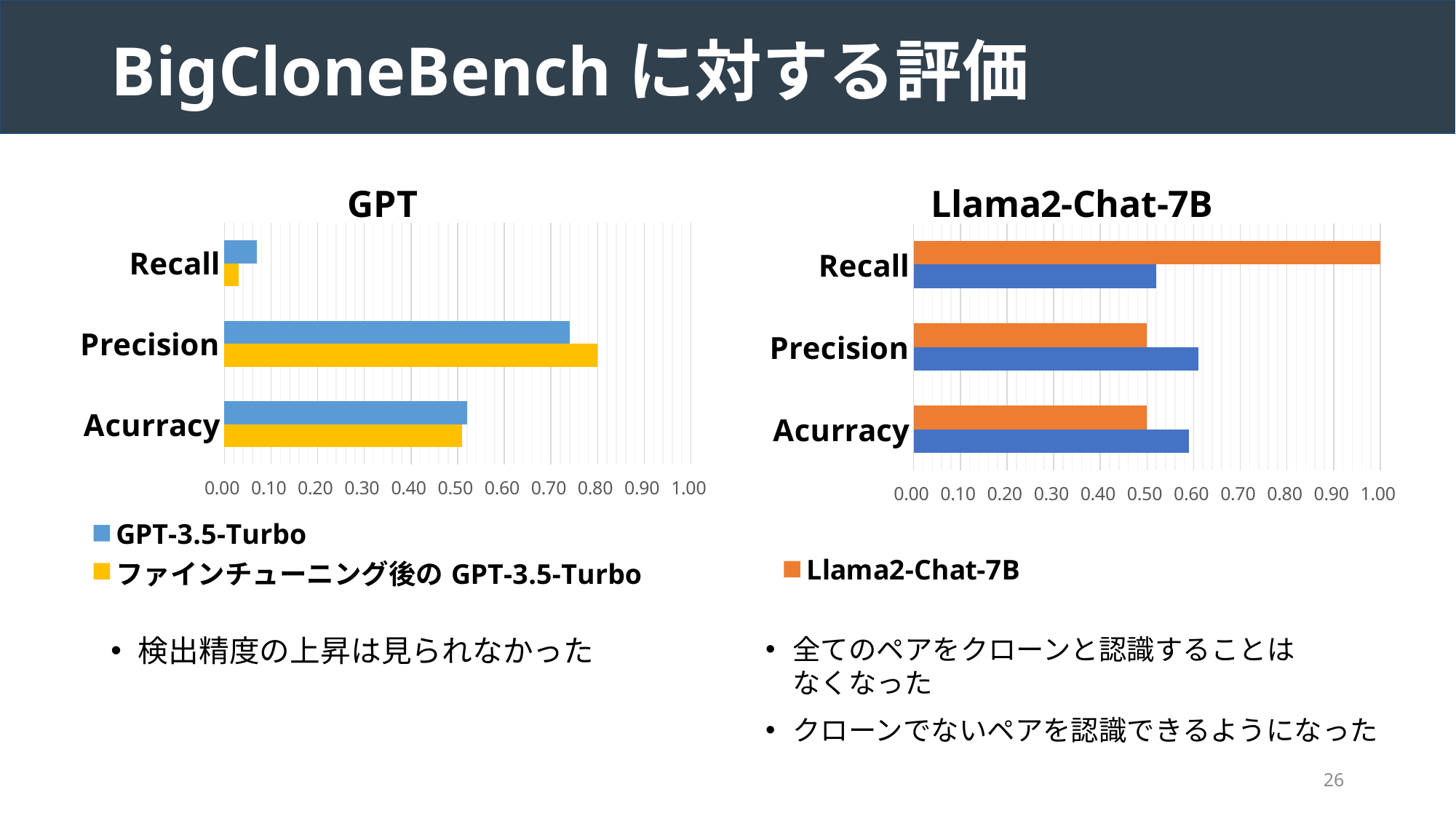
On the GPT chart, is the Recall value for ファインチューニング後の GPT-3.5-Turbo greater or less than 0.10? less How many categories are shown on the GPT chart? 3 On the GPT chart, is the Precision value for GPT-3.5-Turbo greater or less than 0.70? greater What is the title of the chart on the right side of the slide? Llama2-Chat-7B On the GPT chart, which category has the lowest value for ファインチューニング後の GPT-3.5-Turbo? Recall How many series does the legend of the GPT chart list? 2 On the Llama2-Chat-7B chart, is the Precision value for Llama2-Chat-7B greater or less than 0.60? less On the GPT chart, for Precision, which series has the larger value? ファインチューニング後の GPT-3.5-Turbo What kind of chart is the GPT chart? bar chart On the Llama2-Chat-7B chart, what is the Recall value for Llama2-Chat-7B? 1.00 On the GPT chart, which category has the highest value for GPT-3.5-Turbo? Precision On the Llama2-Chat-7B chart, which category has the highest value for Llama2-Chat-7B? Recall